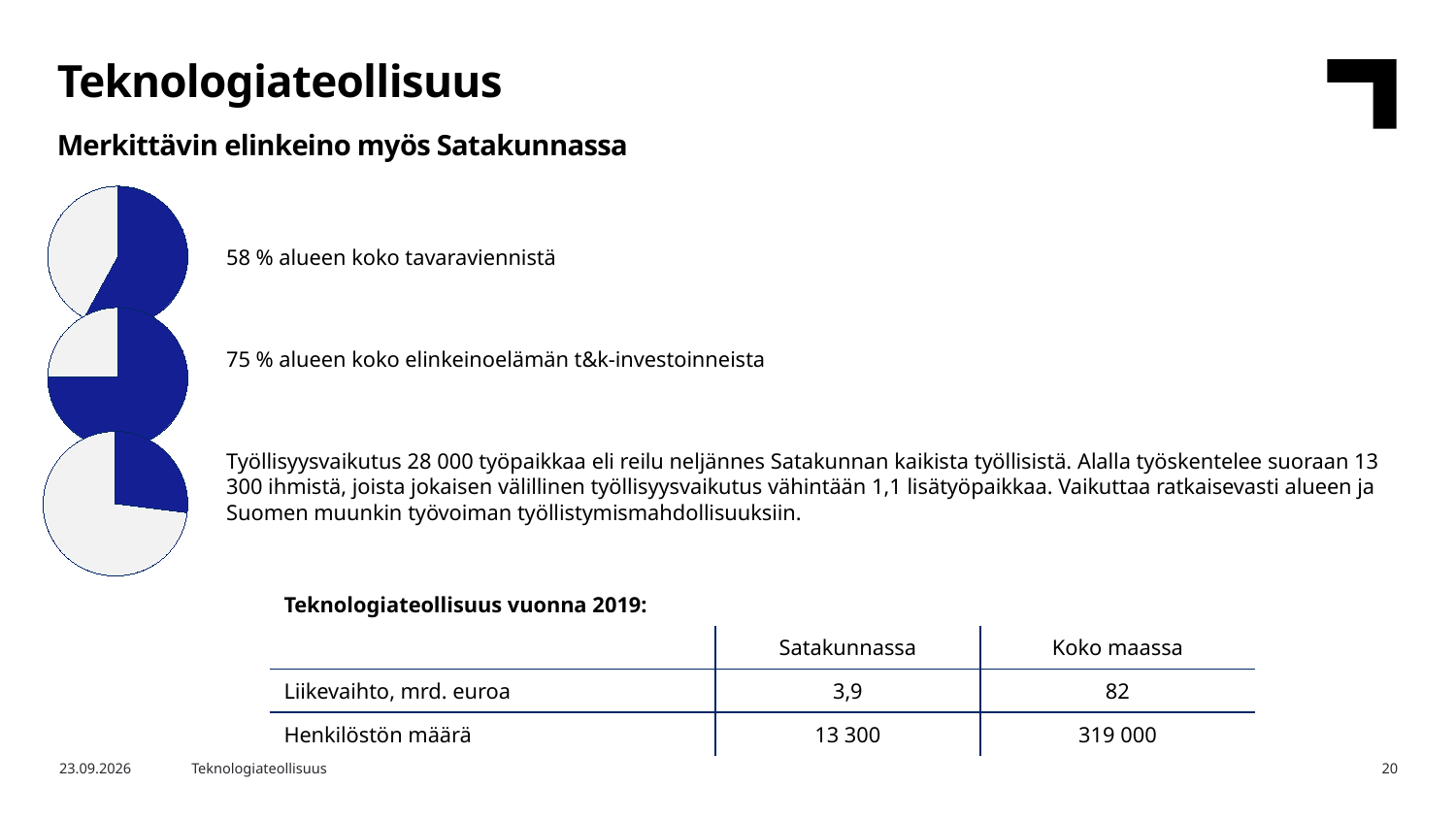
What is the difference in percentage points between the shares shown for the middle pie chart (75 %) and the top pie chart (58 %)? 17 percentage points Is the blue slice larger in the top pie chart or in the bottom pie chart? the top pie chart Which of the three pie charts has the largest blue slice? the middle pie chart How many pie charts are shown on the slide? 3 In the middle pie chart, what share of the region's business R&D investments does the blue slice represent, according to the text beside it? 75 % What colour is used for the highlighted slice in each of the pie charts? blue Is the blue slice larger in the top pie chart or in the middle pie chart? the middle pie chart In the bottom pie chart, is the blue slice more or less than half of the pie? less How many slices does each pie chart have? 2 What kind of chart is used for the three graphics on the left side of the slide? pie chart Which of the three pie charts has the smallest blue slice? the bottom pie chart In the top pie chart, what share of the region's total goods exports does the blue slice represent, according to the text beside it? 58 %